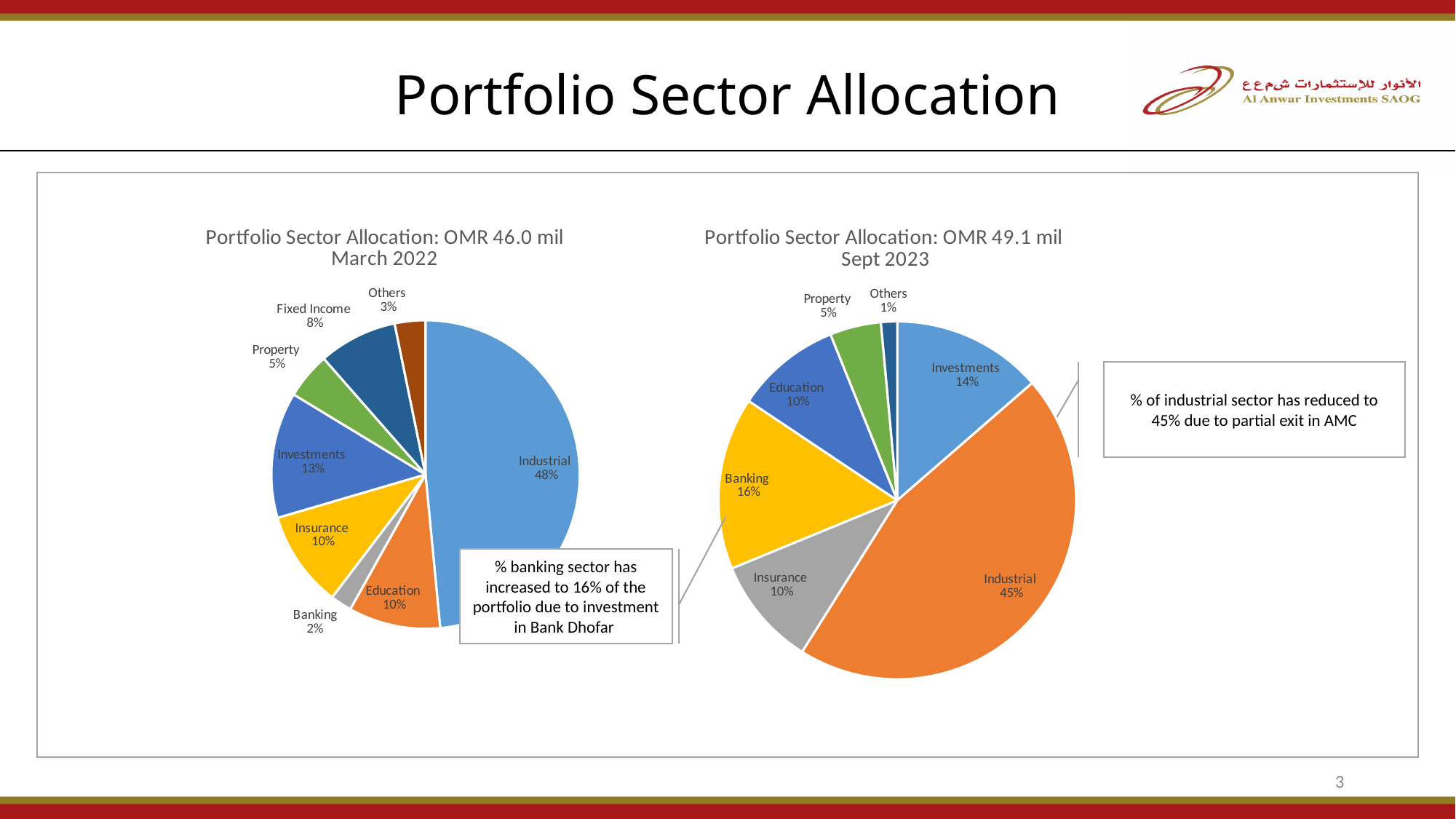
How many sectors are shown in the Sept 2023 chart? 7 How many sectors are shown in the March 2022 chart? 8 What type of chart is used on this slide? Pie chart In the Sept 2023 chart, what share of the portfolio is Banking? 16% In the March 2022 chart, what share of the portfolio is Industrial? 48% In the Sept 2023 chart, which sector has the largest share? Industrial What is the difference between the Industrial share in March 2022 and in Sept 2023? 3% In the March 2022 chart, what share of the portfolio is Fixed Income? 8% In the Sept 2023 chart, which sector has the smallest share? Others In the March 2022 chart, which sector has the smallest share? Banking Which is larger: the Banking share in March 2022 or the Banking share in Sept 2023? Sept 2023 In the Sept 2023 chart, what share of the portfolio is Investments? 14%